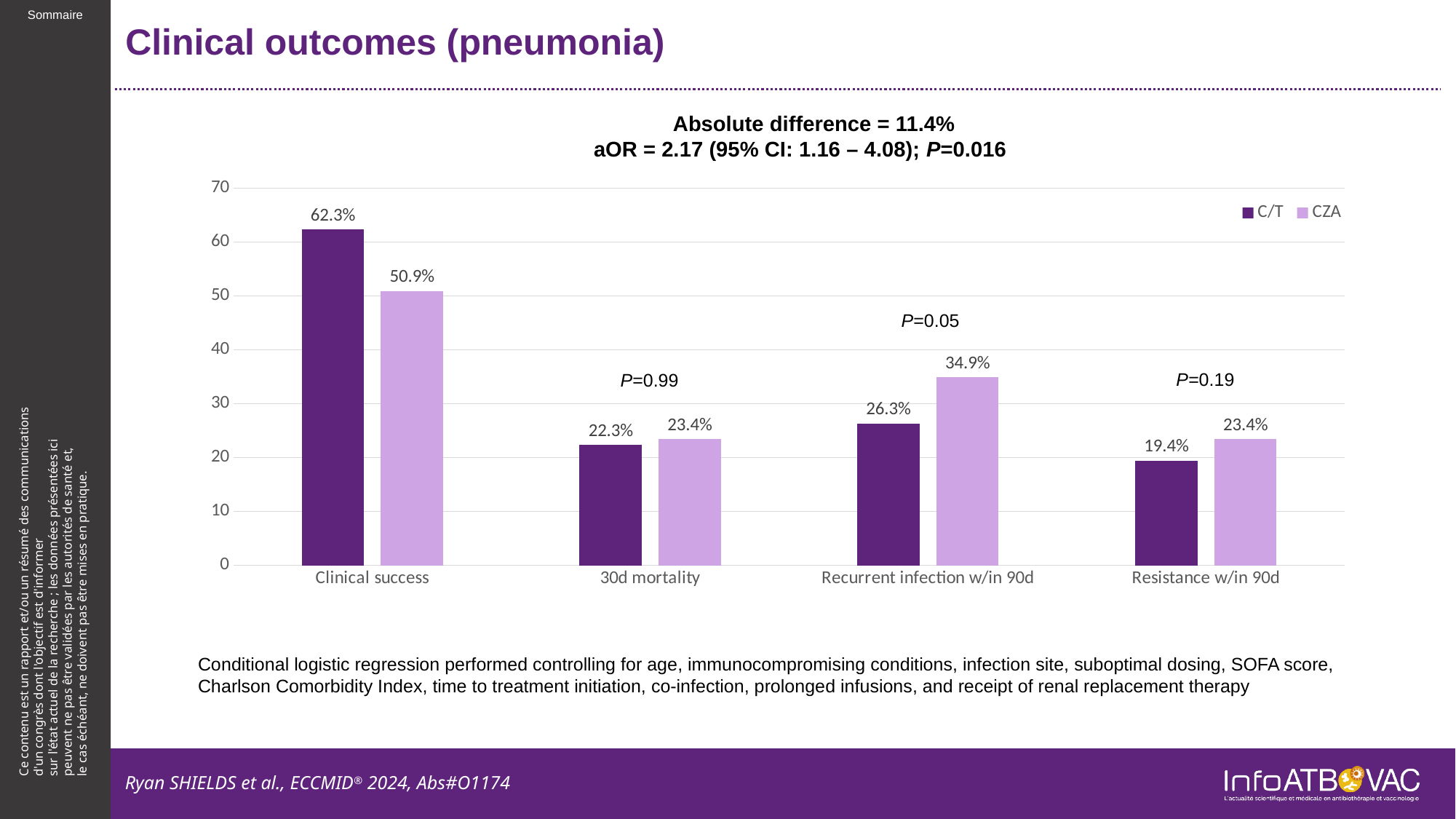
Which category has the highest C/T value? Clinical success What is the C/T value for Resistance w/in 90d? 19.4% What kind of chart is shown on the slide? Bar chart What is the C/T value for Clinical success? 62.3% Which category has the lowest C/T value? Resistance w/in 90d How many categories are shown on the x axis? 4 What P value is shown above the 30d mortality bars? P=0.99 What is the CZA value for Recurrent infection w/in 90d? 34.9% What is the difference between the C/T and CZA values for Clinical success? 11.4% What is the CZA value for 30d mortality? 23.4% How many series does the legend list? 2 For Recurrent infection w/in 90d, which series has the larger value, C/T or CZA? CZA